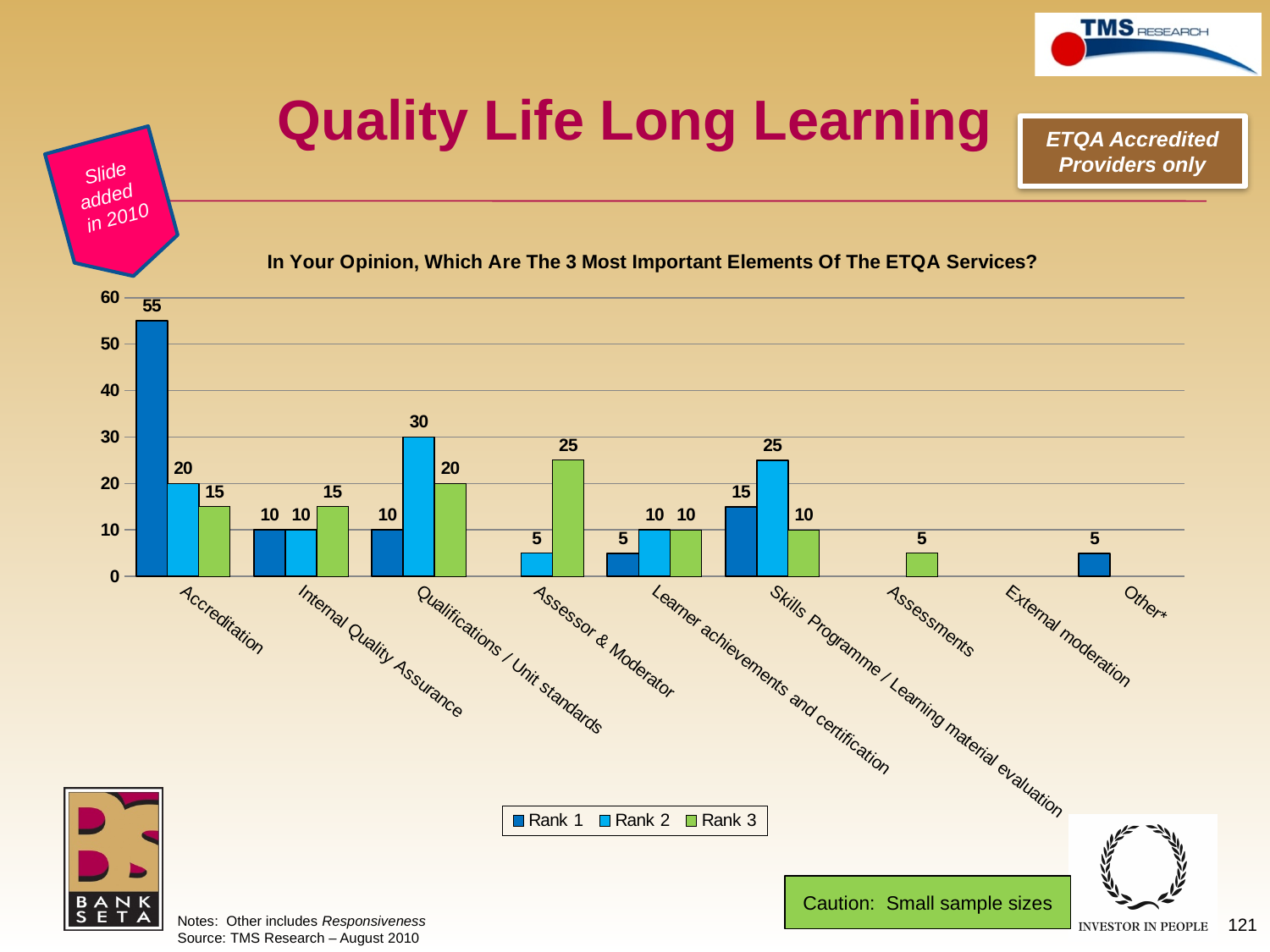
What kind of chart is shown on the slide? Bar chart Which is larger: the Rank 3 value for Qualifications / Unit standards or the Rank 3 value for Internal Quality Assurance? Qualifications / Unit standards Which category has the highest Rank 1 value? Accreditation What is the Rank 1 value for Accreditation? 55 What is the Rank 2 value for Skills Programme / Learning material evaluation? 25 What is the Rank 3 value for Assessor & Moderator? 25 What is the title of the chart? In Your Opinion, Which Are The 3 Most Important Elements Of The ETQA Services? What is the Rank 2 value for Qualifications / Unit standards? 30 What is the difference between the Rank 1 and Rank 2 values for Accreditation? 35 What is the Rank 3 value for Assessments? 5 How many series does the legend list? 3 How many categories are shown on the x axis? 9